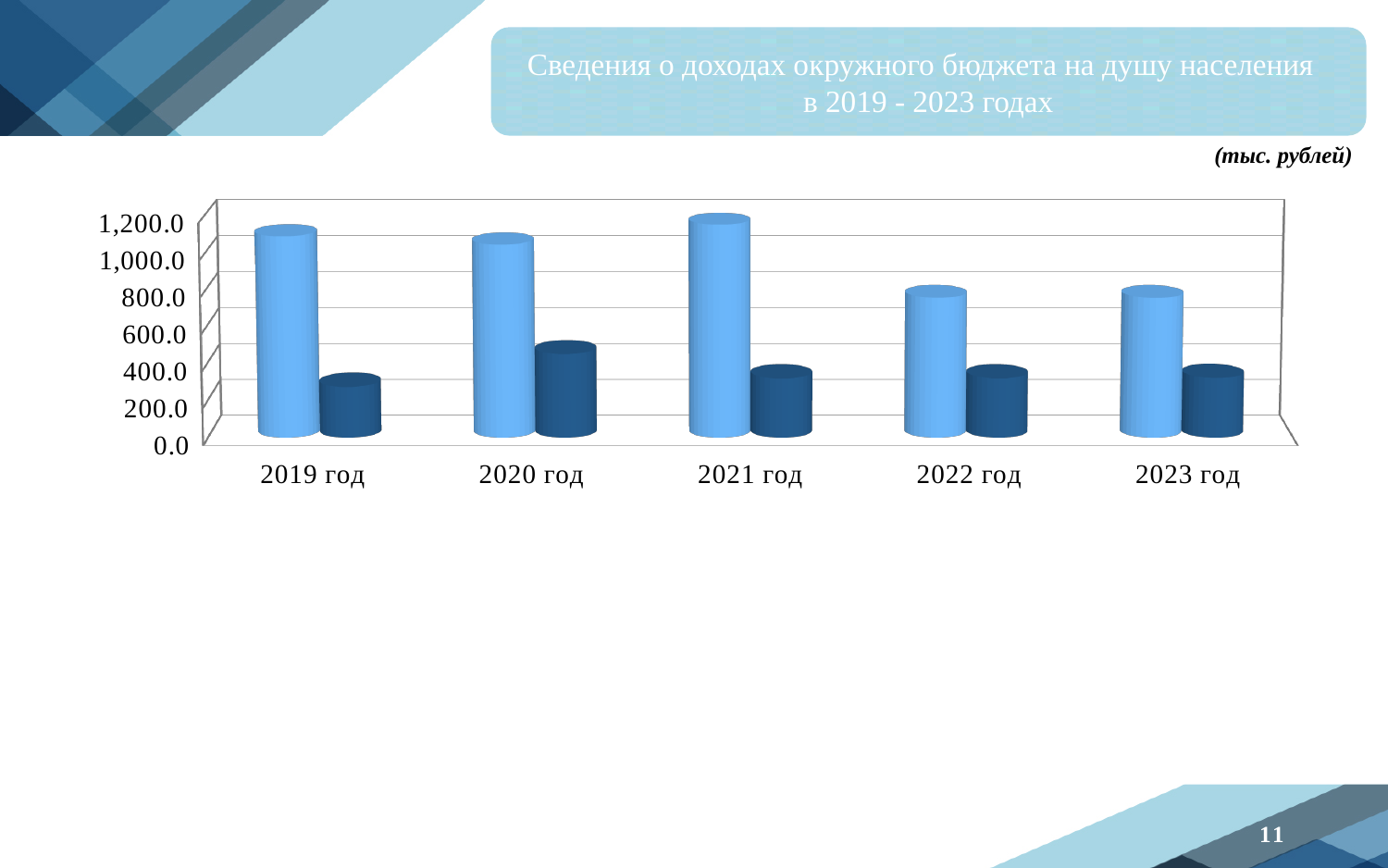
Is the dark blue bar for 2019 год greater or less than 400.0? less What unit is indicated for the chart values? тыс. рублей Which is larger, the light blue bar for 2021 год or the light blue bar for 2022 год? 2021 год In which year is the dark blue bar the highest? 2020 год Is the light blue bar for 2019 год greater or less than 1,000.0? greater Is the light blue bar for 2022 год greater or less than 1,000.0? less Do the light blue bars rise or fall from 2021 год to 2023 год? fall In which year is the light blue bar the highest? 2021 год What kind of chart is shown on the slide? bar chart How many year categories are shown on the x axis? 5 How many bars are shown for each year? 2